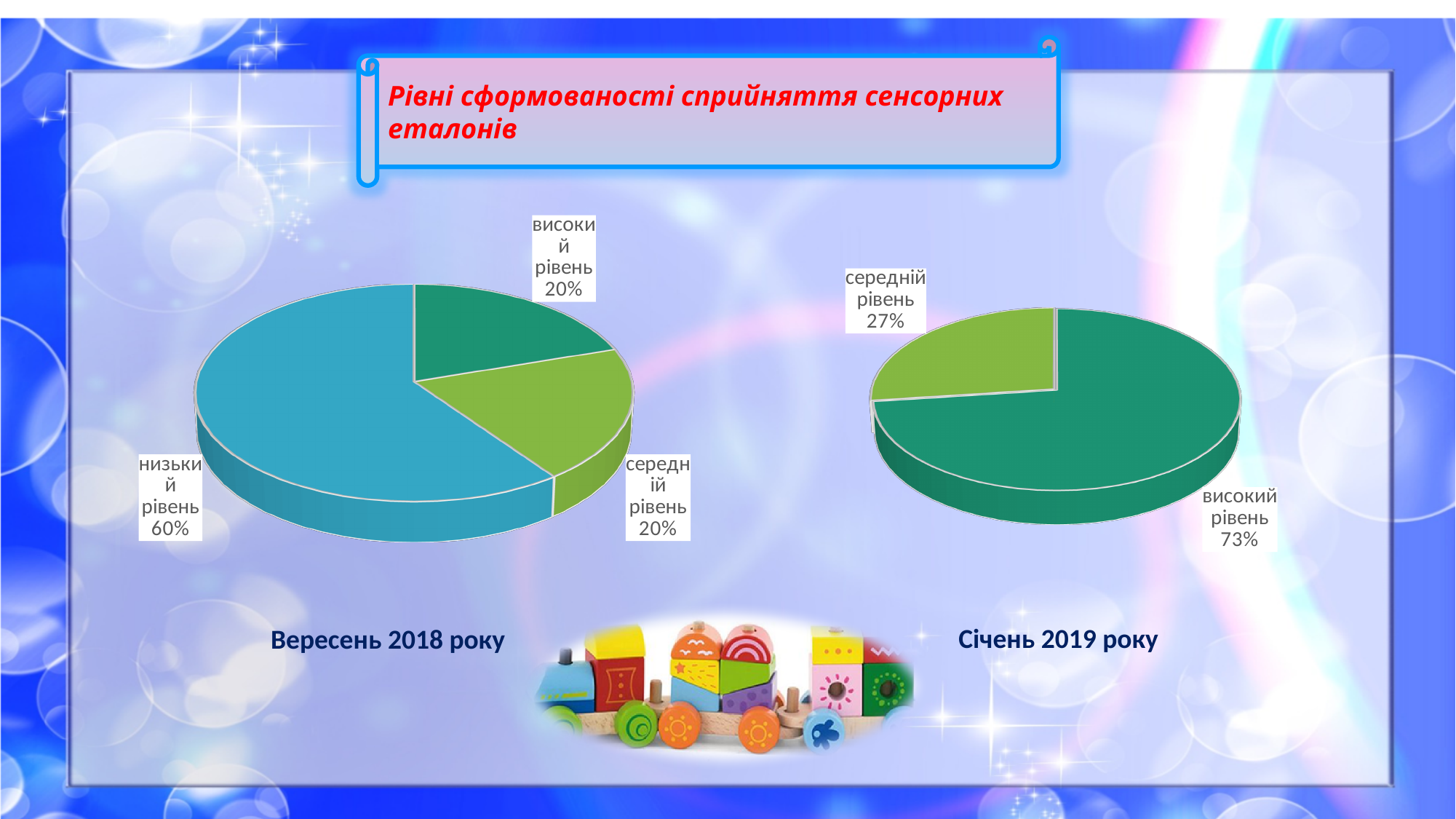
How many slices does the left pie chart (Вересень 2018 року) have? 3 In the left pie chart (Вересень 2018 року), what share is labelled for високий рівень? 20% In the right pie chart (Січень 2019 року), which level has the smallest slice? середній рівень In the right pie chart (Січень 2019 року), what share is labelled for високий рівень? 73% Which is larger: високий рівень in the left chart (Вересень 2018 року) or високий рівень in the right chart (Січень 2019 року)? Січень 2019 року In the right pie chart (Січень 2019 року), what share is labelled for середній рівень? 27% In the left pie chart (Вересень 2018 року), what share is labelled for низький рівень? 60% In the left pie chart (Вересень 2018 року), which level has the largest slice? низький рівень What type of chart is used on this slide? Pie chart In the left pie chart (Вересень 2018 року), what is the difference between the низький рівень and середній рівень shares? 40% In the right pie chart (Січень 2019 року), what is the difference between the високий рівень and середній рівень shares? 46% How many slices does the right pie chart (Січень 2019 року) have? 2